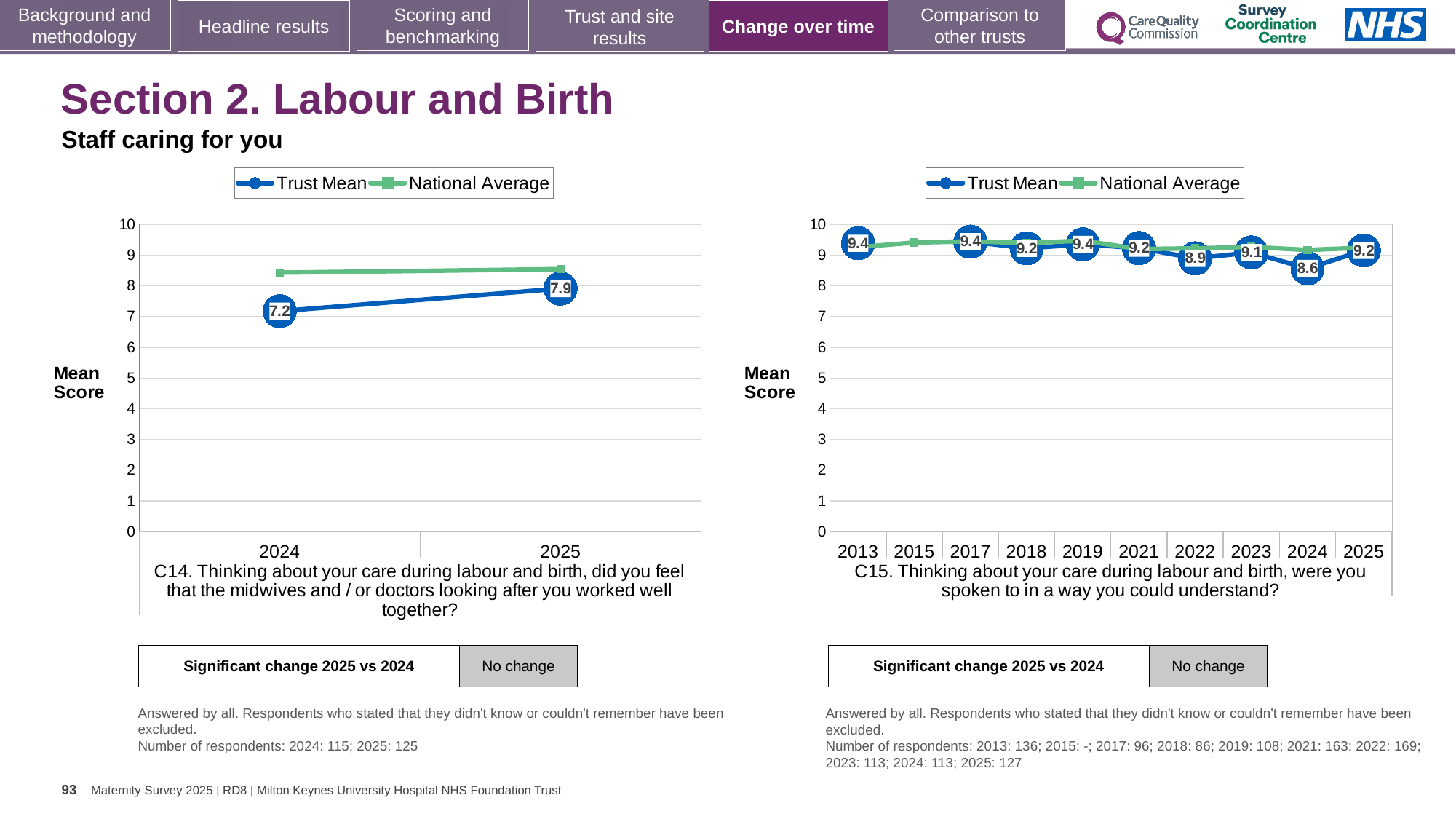
In the C15 chart on the right, what is the Trust Mean score for 2022? 8.9 In the C14 chart on the left, by how much did the Trust Mean change from 2024 to 2025? 0.7 In the C15 chart on the right, which year has the lowest Trust Mean score? 2024 In the C15 chart on the right, what is the difference between the Trust Mean in 2025 and in 2024? 0.6 In the C15 chart on the right, what is the Trust Mean score for 2024? 8.6 In the C14 chart on the left, is the National Average for 2025 greater or less than 8? greater In the C14 chart on the left, which is higher in 2024, the Trust Mean or the National Average? National Average In the C14 chart on the left, does the Trust Mean rise or fall from 2024 to 2025? rise How many series does the legend of the C15 chart on the right list? 2 In the C14 chart on the left, what is the Trust Mean score for 2024? 7.2 How many years are shown on the x axis of the C15 chart on the right? 10 In the C14 chart on the left, what is the Trust Mean score for 2025? 7.9